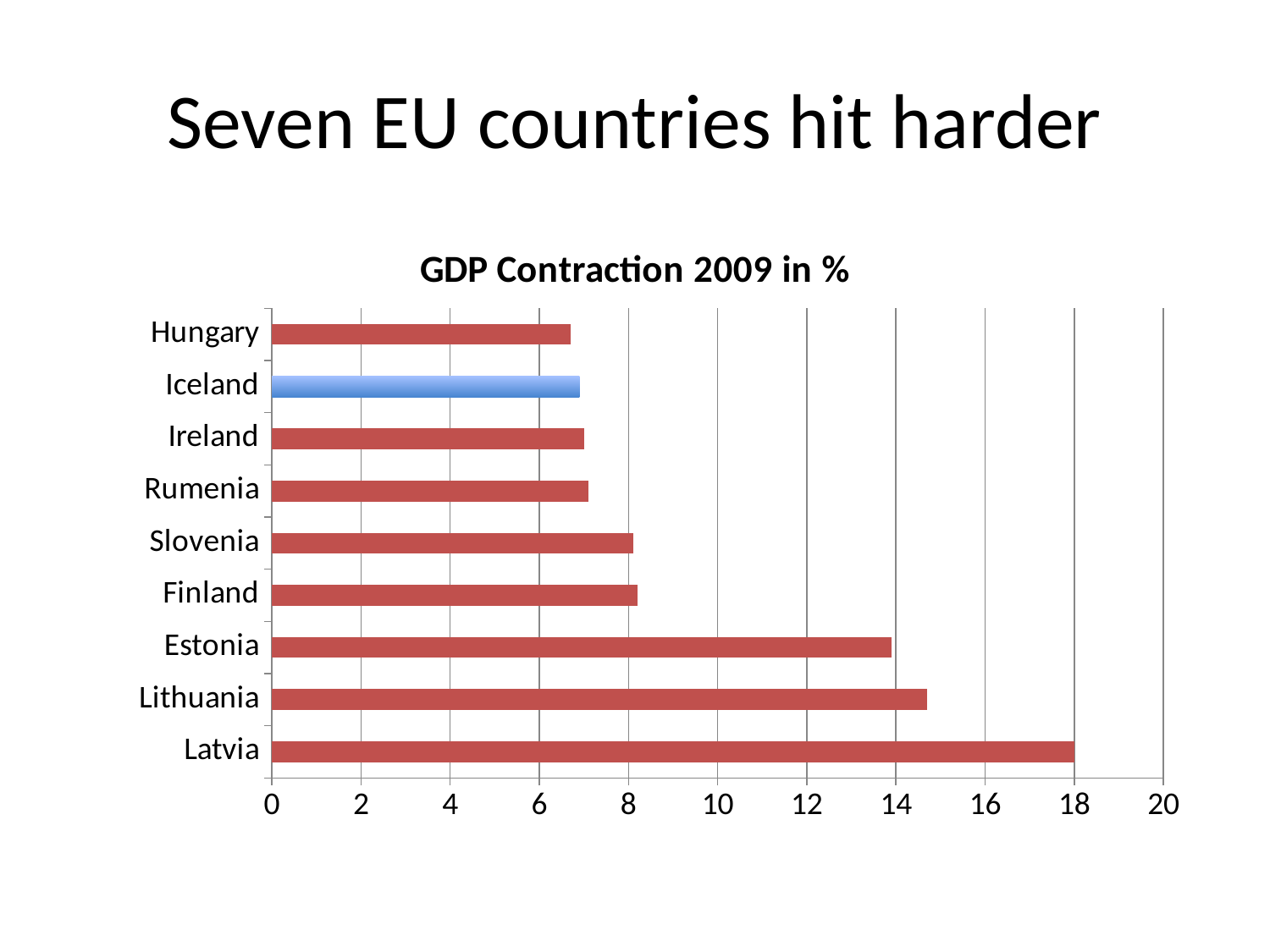
What is the title of the chart? GDP Contraction 2009 in % How many countries are shown in the chart? 9 Which country's bar is coloured differently (blue) from the others? Iceland Is the value for Hungary greater or less than 8? less Which has a larger GDP contraction, Latvia or Lithuania? Latvia What is the GDP contraction value for Latvia? 18 What kind of chart is shown on the slide? bar chart Is the value for Estonia greater or less than 12? greater Which has a larger GDP contraction, Estonia or Finland? Estonia Is the value for Lithuania greater or less than 16? less Which country has the highest GDP contraction in the chart? Latvia